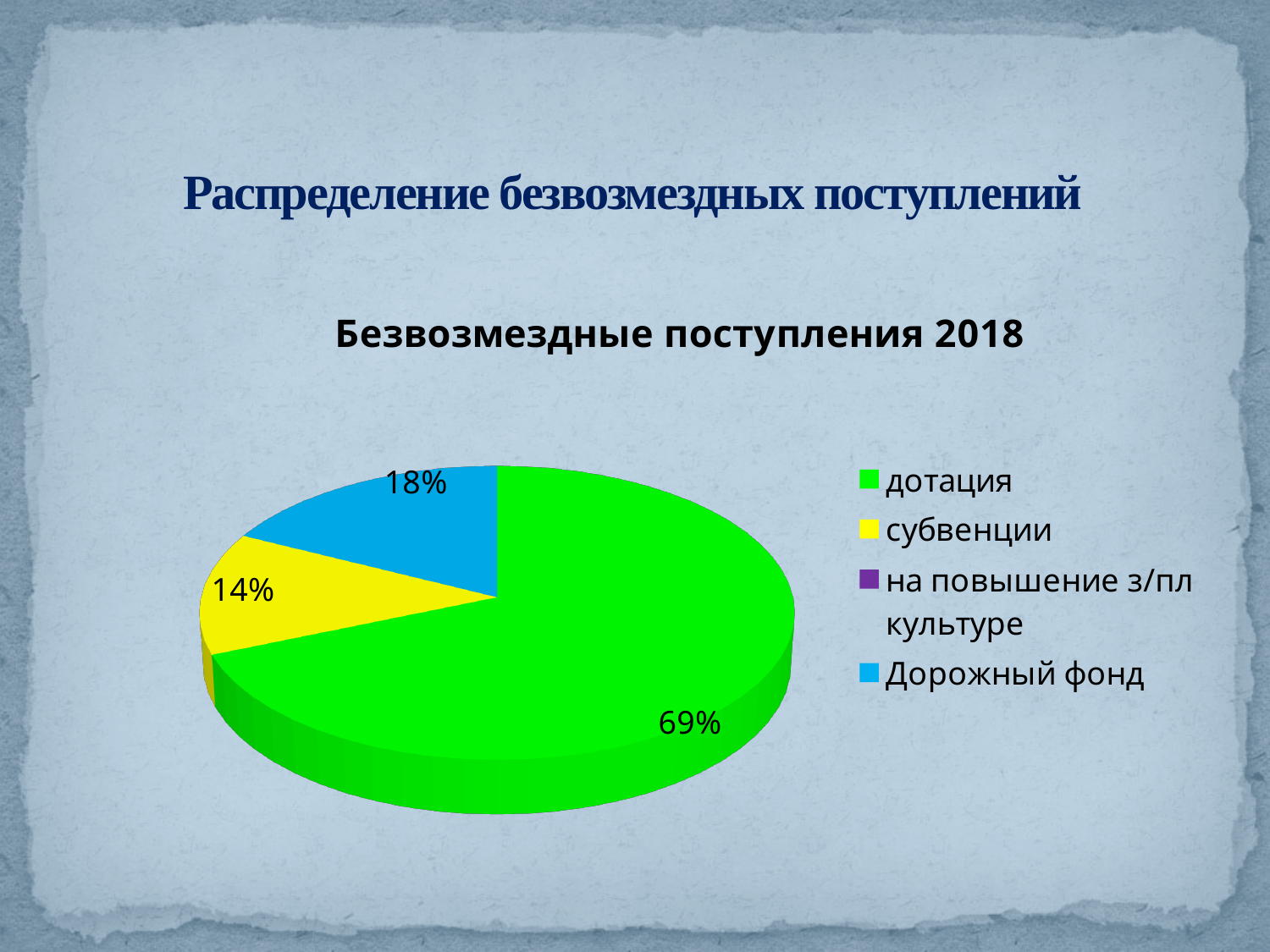
Which is larger, the slice for субвенции or the slice for Дорожный фонд? Дорожный фонд What is the title of the chart? Безвозмездные поступления 2018 What percentage is shown for Дорожный фонд? 18% What type of chart is shown on the slide? Pie chart What colour is the slice for дотация? Green What percentage is shown for субвенции? 14% Which category has the largest slice of the pie? дотация By how many percentage points does Дорожный фонд exceed субвенции? 4 percentage points By how many percentage points does дотация exceed Дорожный фонд? 51 percentage points How many entries does the chart legend list? 4 What share of the pie does дотация account for? 69%